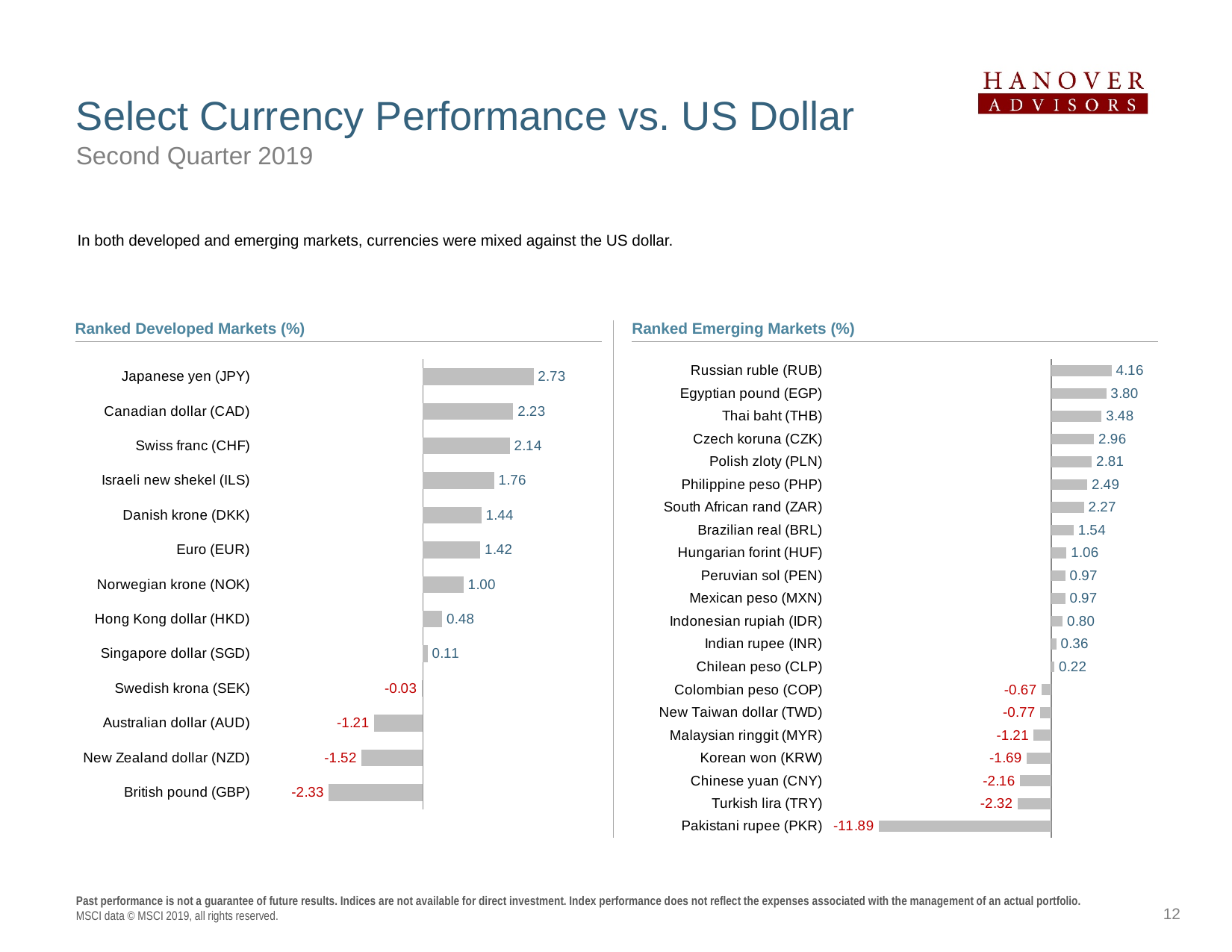
What is the title of the chart on the left side of the slide? Ranked Developed Markets (%) What type of chart is the Ranked Emerging Markets chart? Bar chart In the Ranked Emerging Markets chart, what is the difference between the Egyptian pound (EGP) and the Turkish lira (TRY)? 6.12 In the Ranked Emerging Markets chart, which is larger, the value for the Thai baht (THB) or the Czech koruna (CZK)? Thai baht (THB) How many currencies are shown in the Ranked Emerging Markets chart? 21 In the Ranked Emerging Markets chart, which currency has the highest value? Russian ruble (RUB) In the Ranked Developed Markets chart, what is the value for the Swedish krona (SEK)? -0.03 In the Ranked Developed Markets chart, what is the value for the Japanese yen (JPY)? 2.73 In the Ranked Emerging Markets chart, what is the value for the Pakistani rupee (PKR)? -11.89 How many currencies are shown in the Ranked Developed Markets chart? 13 In the Ranked Developed Markets chart, what is the difference between the Canadian dollar (CAD) and the Swiss franc (CHF)? 0.09 In the Ranked Developed Markets chart, which currency has the lowest value? British pound (GBP)